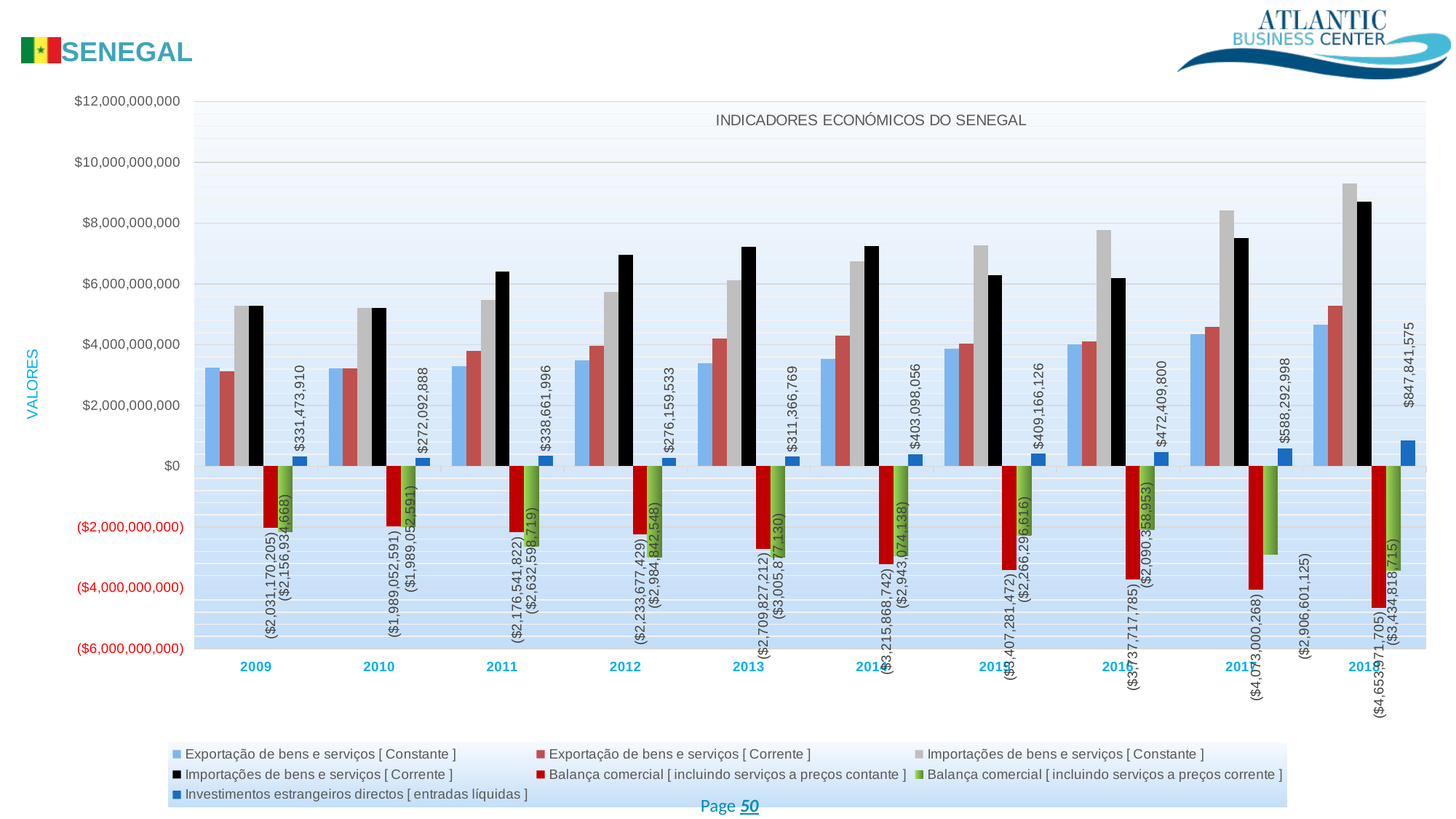
How many years are shown on the x axis of the chart? 10 What is the difference between Investimentos estrangeiros directos [ entradas líquidas ] in 2018 and in 2017? $259,548,577 What is the title of the chart? INDICADORES ECONÓMICOS DO SENEGAL How many series does the chart legend list? 7 In which year is Investimentos estrangeiros directos [ entradas líquidas ] the lowest? 2010 Is the value of Importações de bens e serviços [ Corrente ] in 2018 greater or less than $8,000,000,000? greater In which year is Investimentos estrangeiros directos [ entradas líquidas ] the highest? 2018 What is the value of Investimentos estrangeiros directos [ entradas líquidas ] in 2009? $331,473,910 What is the value of Investimentos estrangeiros directos [ entradas líquidas ] in 2018? $847,841,575 Does Importações de bens e serviços [ Constante ] generally rise or fall from 2009 to 2018? Rise What is the value of Balança comercial [ incluindo serviços a preços contante ] in 2017? ($4,073,000,268) What type of chart is shown on the slide? Bar chart